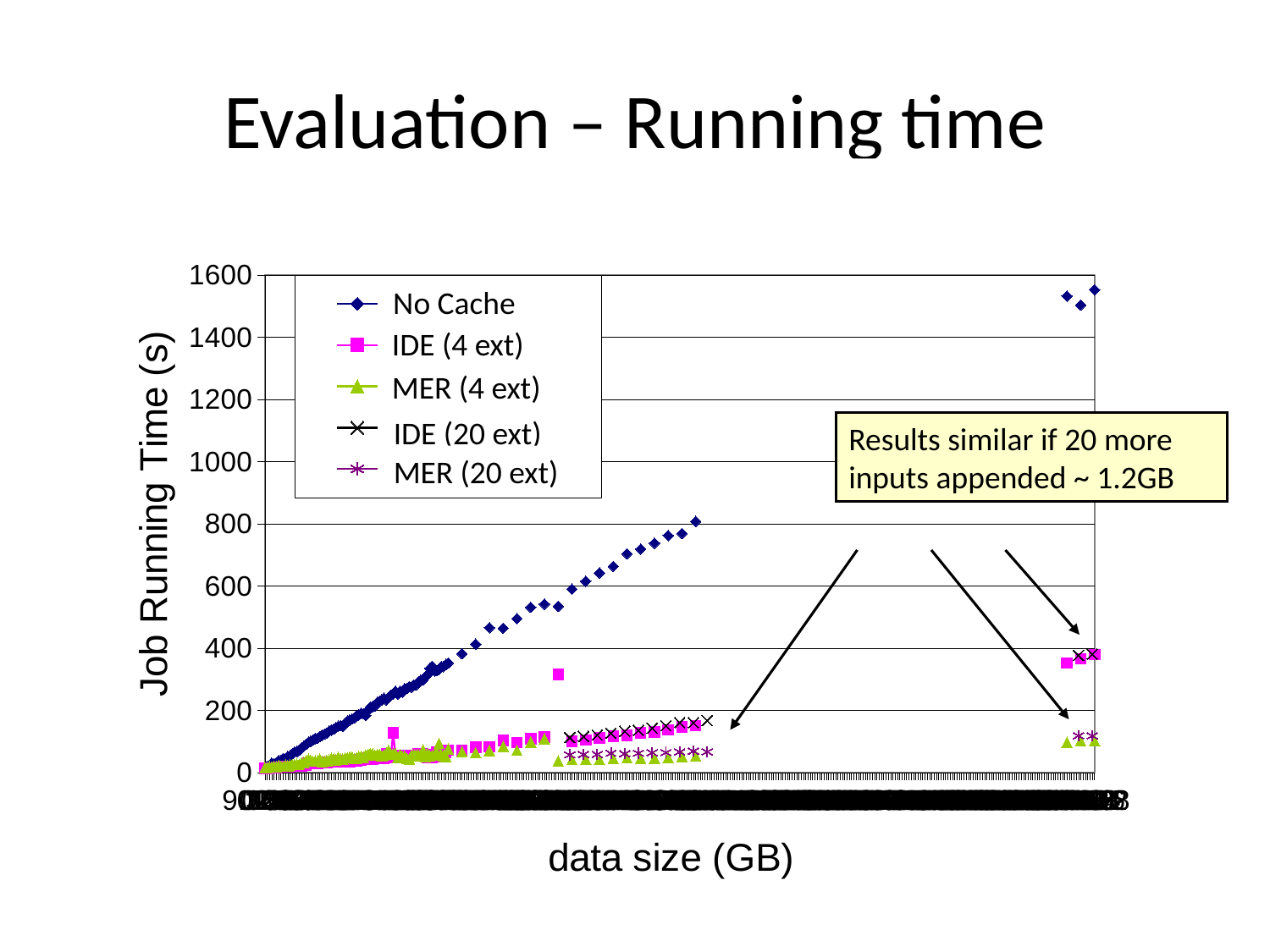
Which series has larger values, No Cache or IDE (20 ext)? No Cache Do the No Cache values rise or fall as data size increases along the x axis? rise Are the highest No Cache values greater or less than 1400? greater Are the rightmost IDE (4 ext) values greater or less than 200? greater Which series reaches the highest job running time values? No Cache What is the title of the x axis? data size (GB) Are the rightmost MER (4 ext) values greater or less than 200? less What kind of chart is shown on the slide? line chart How many series does the legend list? 5 What is the title of the y axis? Job Running Time (s) Which series has larger values, IDE (4 ext) or MER (4 ext)? IDE (4 ext)